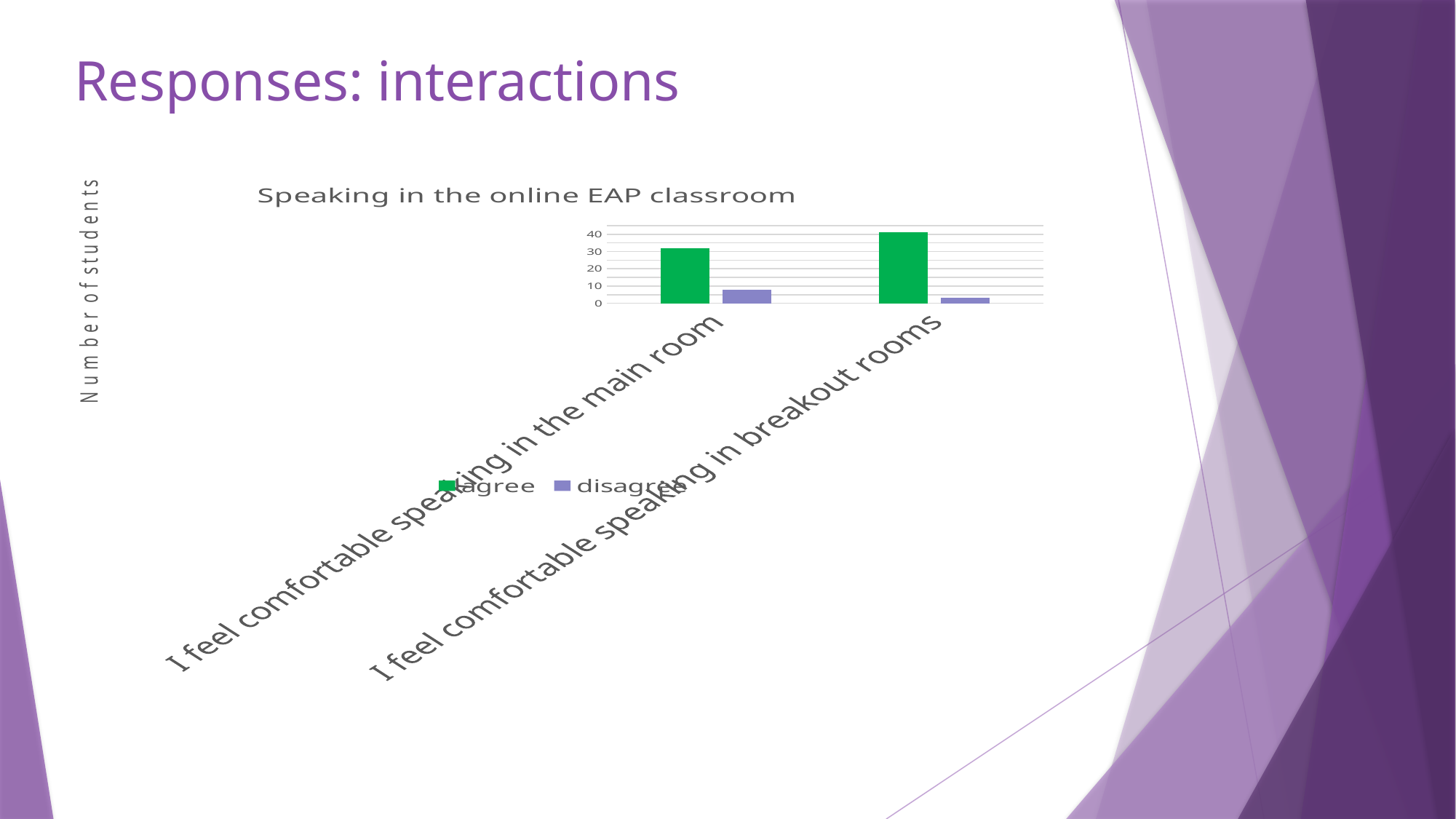
Which series is shown in green? agree How many categories are shown on the x axis? 2 Is the 'agree' value for 'I feel comfortable speaking in the main room' greater or less than 20? greater Which category has the higher 'agree' value: 'I feel comfortable speaking in the main room' or 'I feel comfortable speaking in breakout rooms'? I feel comfortable speaking in breakout rooms Is the 'disagree' value for 'I feel comfortable speaking in breakout rooms' greater or less than 10? less Is the 'disagree' value for 'I feel comfortable speaking in the main room' greater or less than 20? less What kind of chart is shown on the slide? bar chart How many series does the legend list? 2 Which bar is the tallest in the chart? agree for 'I feel comfortable speaking in breakout rooms' Which category has the higher 'disagree' value: 'I feel comfortable speaking in the main room' or 'I feel comfortable speaking in breakout rooms'? I feel comfortable speaking in the main room What is the title of the chart? Speaking in the online EAP classroom